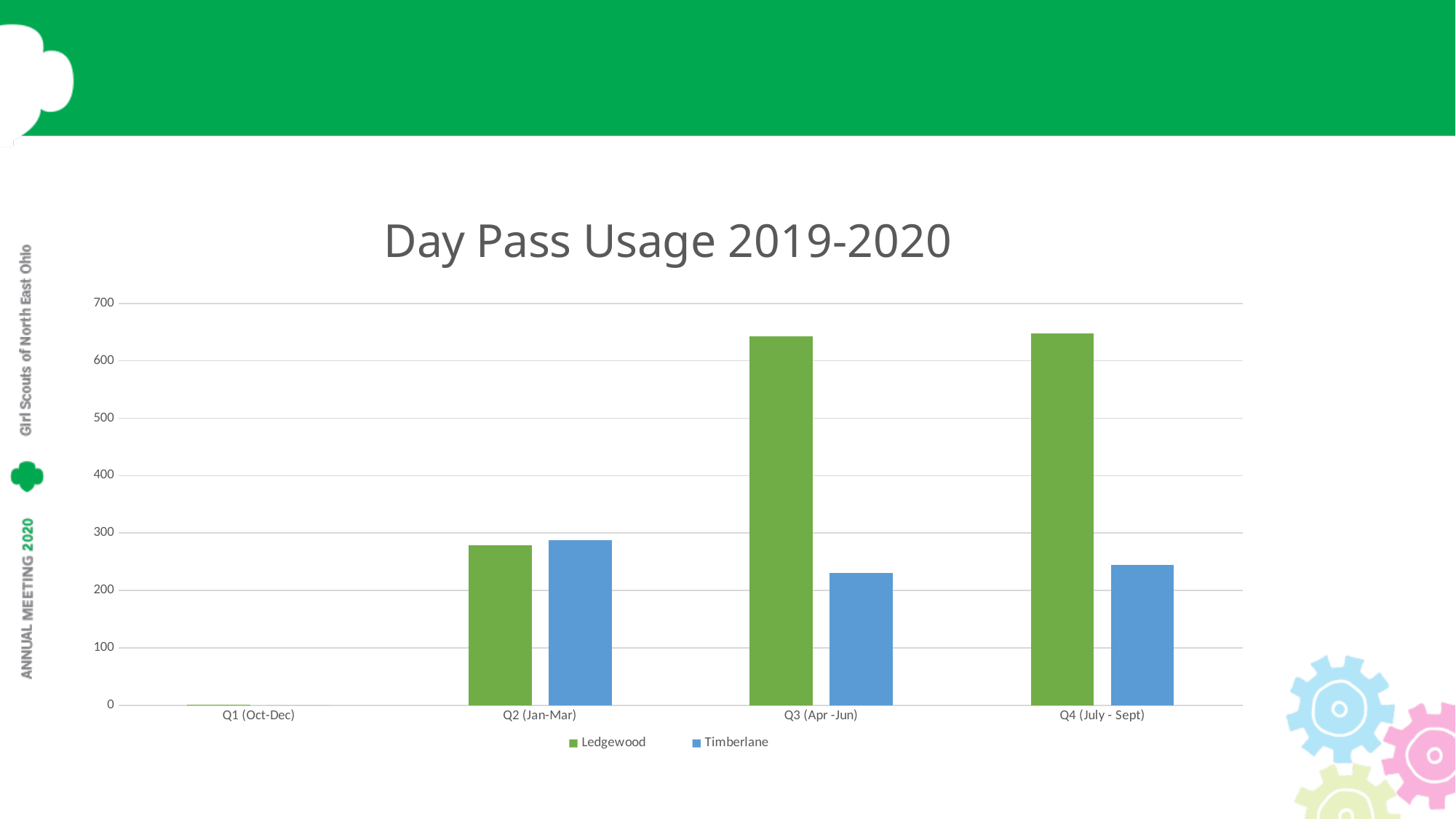
Which series is shown in blue? Timberlane How many quarters are shown on the x axis? 4 Is the value for Timberlane in Q4 (July - Sept) greater or less than 300? less What is the title of the chart? Day Pass Usage 2019-2020 Is the value for Timberlane in Q3 (Apr -Jun) greater or less than 300? less What kind of chart is shown on the slide? Bar chart In Q3 (Apr -Jun), which is larger, Ledgewood or Timberlane? Ledgewood How many series does the legend list? 2 In which quarter is the Ledgewood value lowest? Q1 (Oct-Dec) Is the value for Ledgewood in Q3 (Apr -Jun) greater or less than 600? greater In which quarter is the Timberlane value highest? Q2 (Jan-Mar)